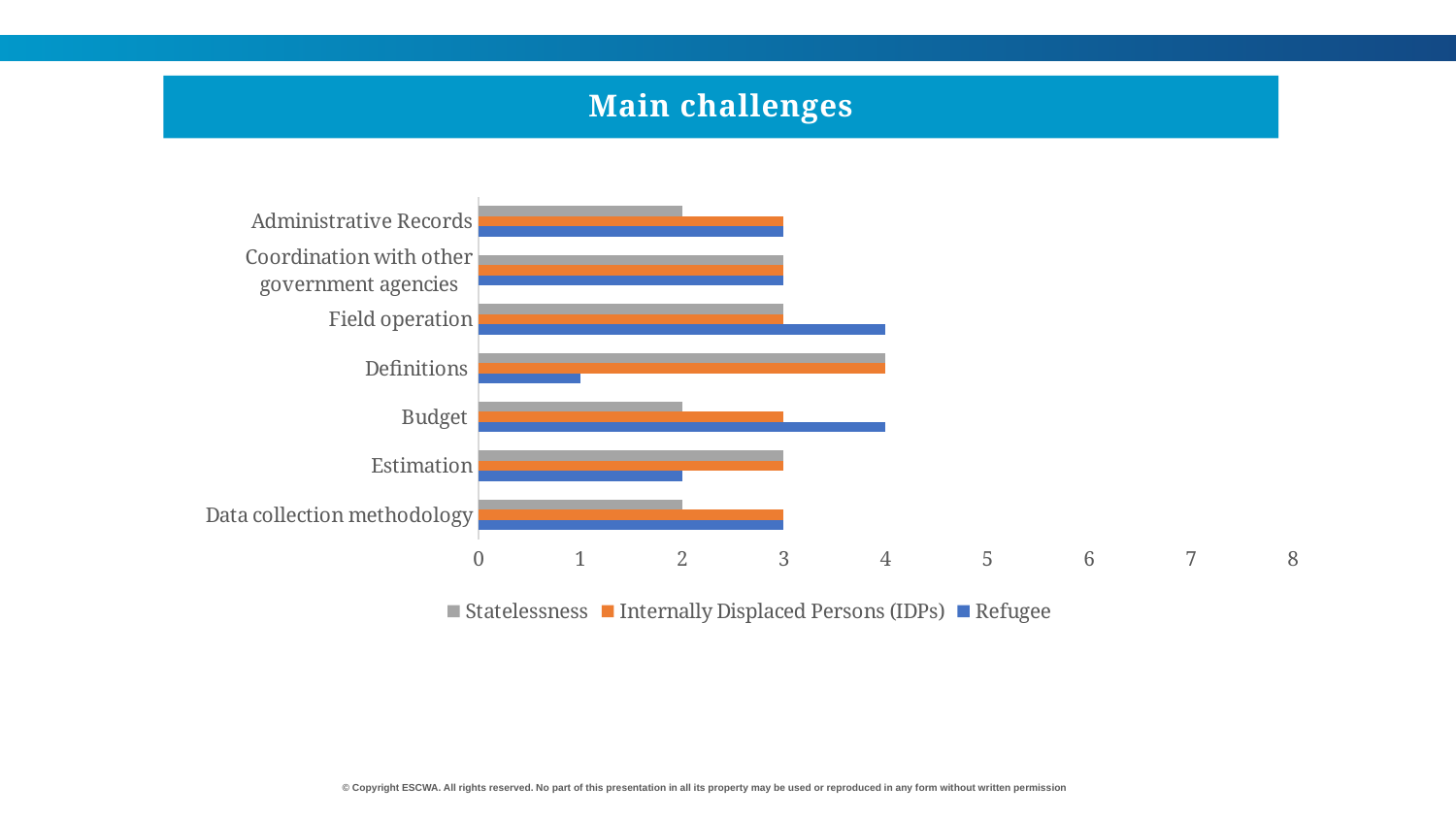
Which category has the lowest Refugee value? Definitions What is the Refugee value for Definitions? 1 What is the Refugee value for Field operation? 4 What is the title of the chart? Main challenges What kind of chart is shown on the slide? Bar chart How many categories are shown on the chart? 7 What is the Statelessness value for Budget? 2 What is the difference between the Refugee value and the Statelessness value for Budget? 2 Which category has the highest Statelessness value? Definitions For Estimation, which is larger: the Internally Displaced Persons (IDPs) value or the Refugee value? Internally Displaced Persons (IDPs) How many series does the legend list? 3 Which series is shown in orange in the legend? Internally Displaced Persons (IDPs)